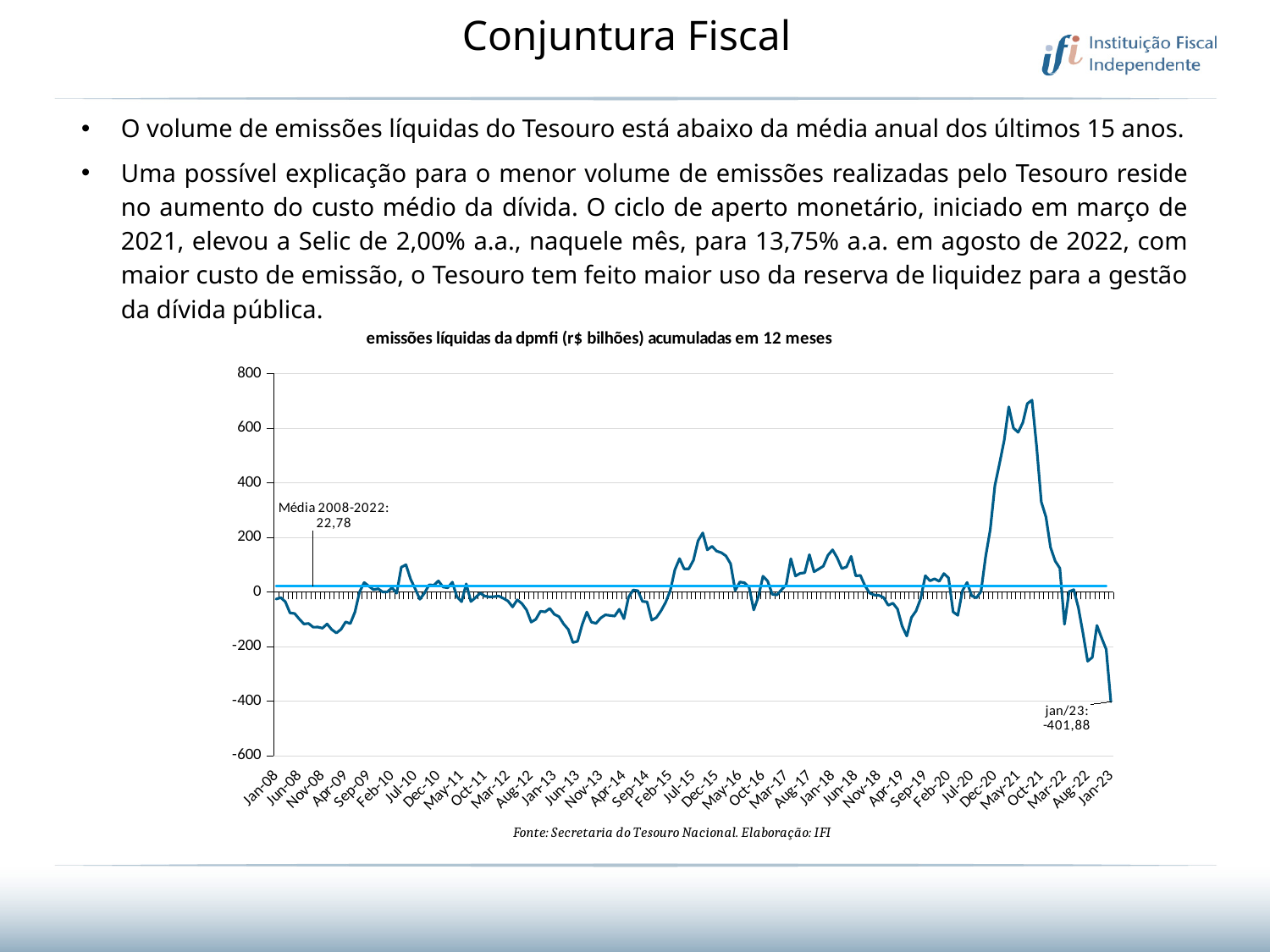
Is the 2008-2022 average line above or below 0? above What kind of chart is shown on the slide? line chart What is the value of net issuances (emissões líquidas) labelled for jan/23? -401,88 What is the 2008-2022 average (Média 2008-2022) shown on the chart? 22,78 Is the value at Jan-23 greater or less than -200? less What is the title of the chart? emissões líquidas da dpmfi (r$ bilhões) acumuladas em 12 meses What source is cited below the chart? Secretaria do Tesouro Nacional Is the value at Jan-08 greater or less than 200? less Between Oct-21 and Jan-23, does the line rise or fall overall? fall Is the jan/23 value larger or smaller than the 2008-2022 average? smaller By how much is the jan/23 value below the 2008-2022 average of 22,78? 424,66